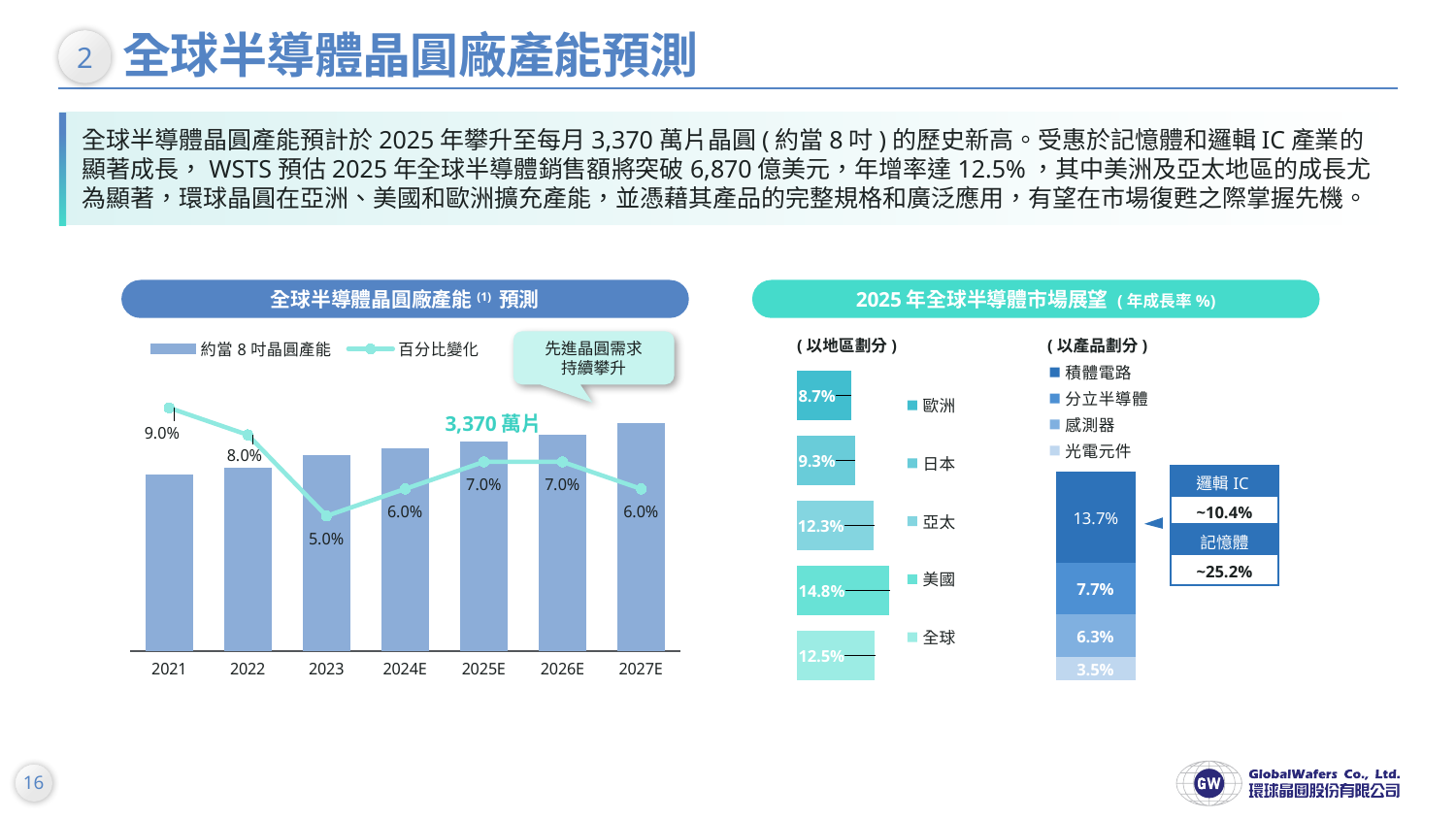
In the 以地區劃分 chart under 2025年全球半導體市場展望, which is larger, the growth rate for 亞太 or 日本? 亞太 In the chart titled 全球半導體晶圓廠產能(1)預測, what is the difference between the 百分比變化 for 2021 and 2023? 4.0% In the chart titled 全球半導體晶圓廠產能(1)預測, which year has the lowest 百分比變化? 2023 In the 以地區劃分 chart under 2025年全球半導體市場展望, which region has the lowest growth rate? 歐洲 In the chart titled 全球半導體晶圓廠產能(1)預測, which year has the highest 百分比變化? 2021 In the 以產品劃分 chart under 2025年全球半導體市場展望, what is the growth rate for 感測器? 6.3% In the chart titled 全球半導體晶圓廠產能(1)預測, what is the 百分比變化 value for 2023? 5.0% In the 以地區劃分 chart under 2025年全球半導體市場展望, what is the growth rate for 美國? 14.8% In the chart titled 全球半導體晶圓廠產能(1)預測, how many series does the legend list? 2 In the chart titled 全球半導體晶圓廠產能(1)預測, what capacity value is labelled for 2025E? 3,370 萬片 In the chart titled 全球半導體晶圓廠產能(1)預測, what is the 百分比變化 value for 2021? 9.0% In the chart titled 全球半導體晶圓廠產能(1)預測, how many years are shown on the x axis? 7